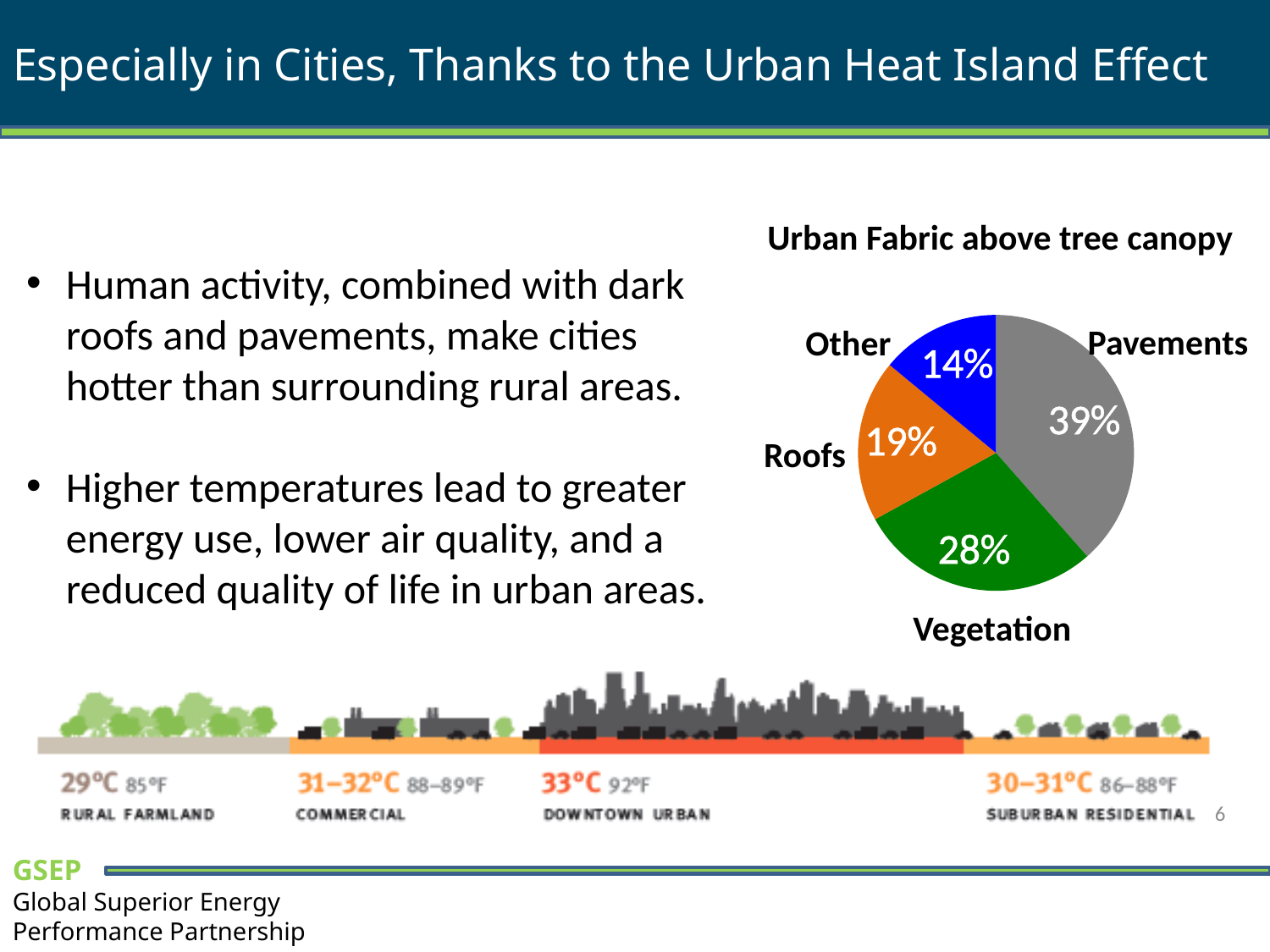
What type of chart is shown on the slide? Pie chart Which category has the smallest slice in the pie chart? Other What share of the pie chart does Pavements represent? 39% What share of the pie chart does Roofs represent? 19% Which category has the largest slice in the pie chart? Pavements Which is larger in the pie chart, Roofs or Vegetation? Vegetation What colour is the Vegetation slice in the pie chart? Green What is the title of the pie chart? Urban Fabric above tree canopy What is the difference in percentage points between Pavements and Vegetation in the pie chart? 11 How many categories are shown in the pie chart? 4 What share of the pie chart does Vegetation represent? 28% What share of the pie chart does Other represent? 14%